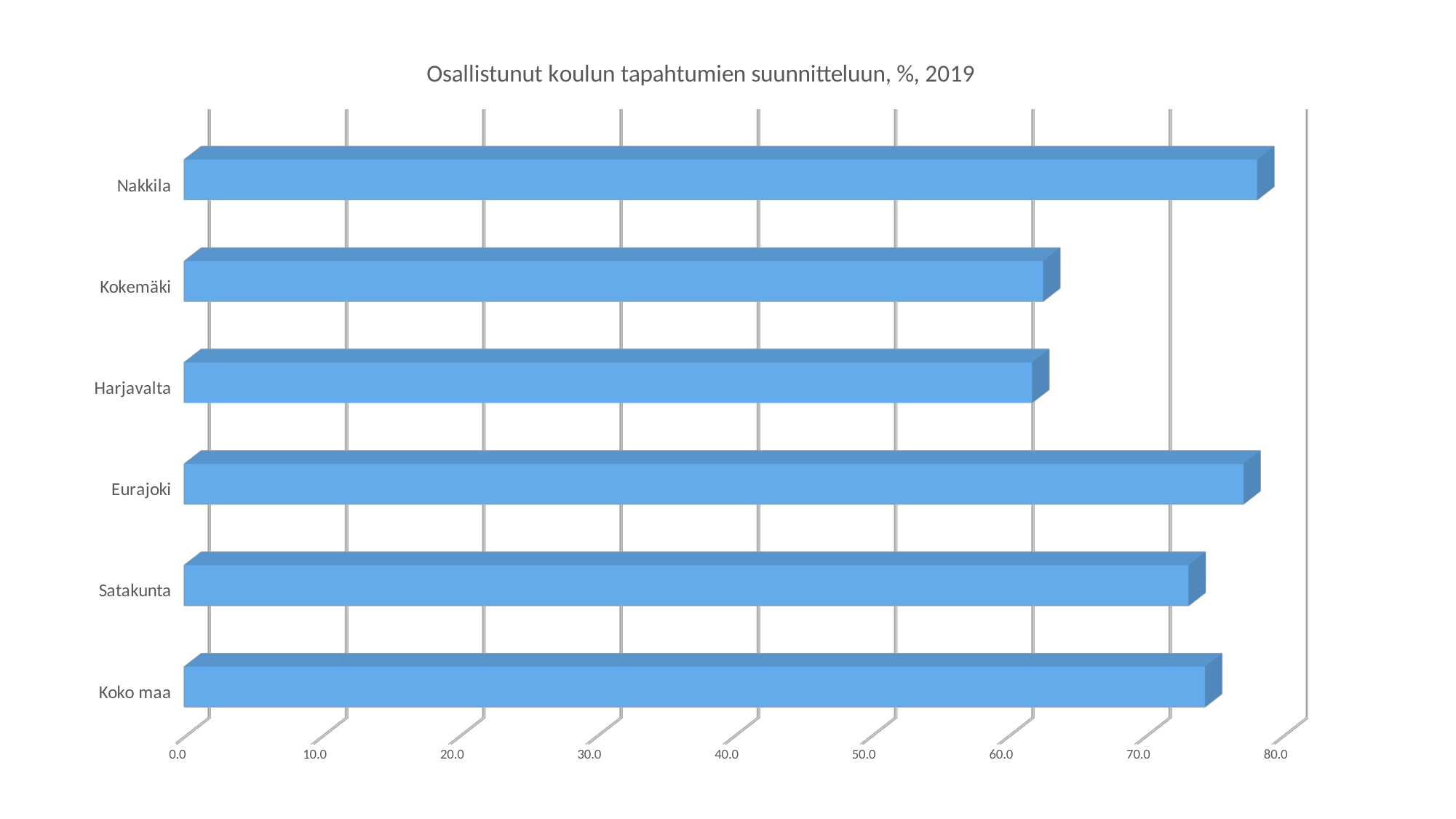
Which has the larger value, Koko maa or Kokemäki? Koko maa Is the value for Eurajoki greater or less than 70? greater What kind of chart is shown on the slide? bar chart What is the title of the chart? Osallistunut koulun tapahtumien suunnitteluun, %, 2019 Is the value for Kokemäki greater or less than 70? less Is the value for Koko maa greater or less than 80? less How many categories are shown in the chart? 6 Which has the larger value, Nakkila or Kokemäki? Nakkila Which has the larger value, Harjavalta or Eurajoki? Eurajoki